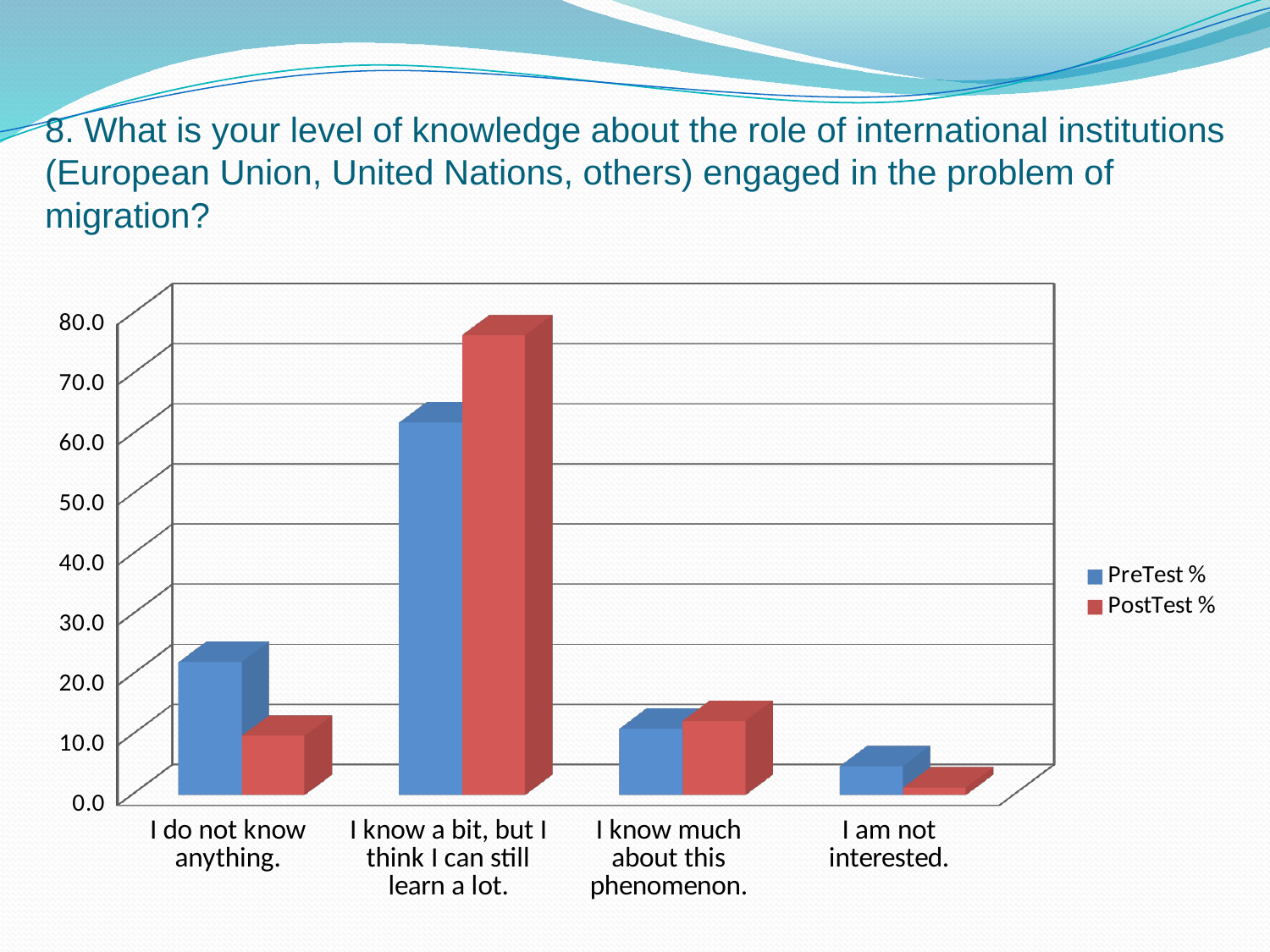
Which category has the highest PreTest % value? I know a bit, but I think I can still learn a lot. What are the two series named in the legend? PreTest % and PostTest % Is the PostTest % value for 'I know a bit, but I think I can still learn a lot.' greater or less than 70.0? greater What kind of chart is shown on the slide? bar chart For 'I do not know anything.', which is larger: the PreTest % or the PostTest % value? PreTest % Which colour represents the PostTest % series? red How many categories are shown on the x axis of the chart? 4 Is the PreTest % value for 'I am not interested.' greater or less than 10.0? less Which category has the lowest PostTest % value? I am not interested. How many series does the chart's legend list? 2 Which category has the highest PostTest % value? I know a bit, but I think I can still learn a lot. For 'I know a bit, but I think I can still learn a lot.', which is larger: the PreTest % or the PostTest % value? PostTest %